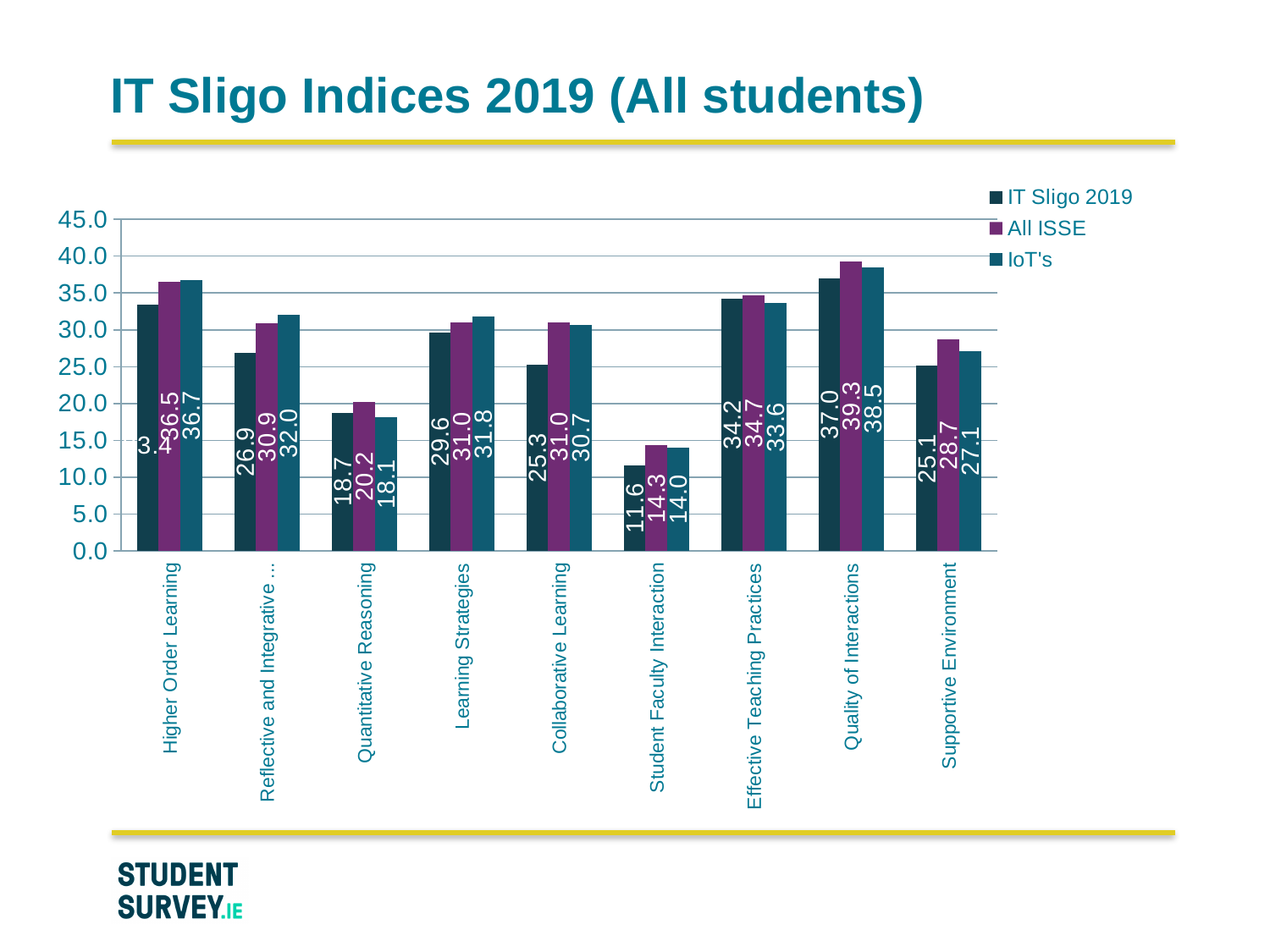
Which category has the lowest IT Sligo 2019 value? Student Faculty Interaction Which category has the highest All ISSE value? Quality of Interactions What type of chart is shown on the slide? bar chart How many series does the legend list? 3 What is the IoT's value for Supportive Environment? 27.1 Is the IoT's value for Learning Strategies greater or less than 30.0? greater Which series is shown in purple in the legend? All ISSE For Quantitative Reasoning, which is larger: the IT Sligo 2019 value or the IoT's value? IT Sligo 2019 What is the All ISSE value for Student Faculty Interaction? 14.3 What is the IT Sligo 2019 value for Quality of Interactions? 37.0 How many categories are shown on the x axis? 9 What is the difference between the All ISSE and IT Sligo 2019 values for Collaborative Learning? 5.7